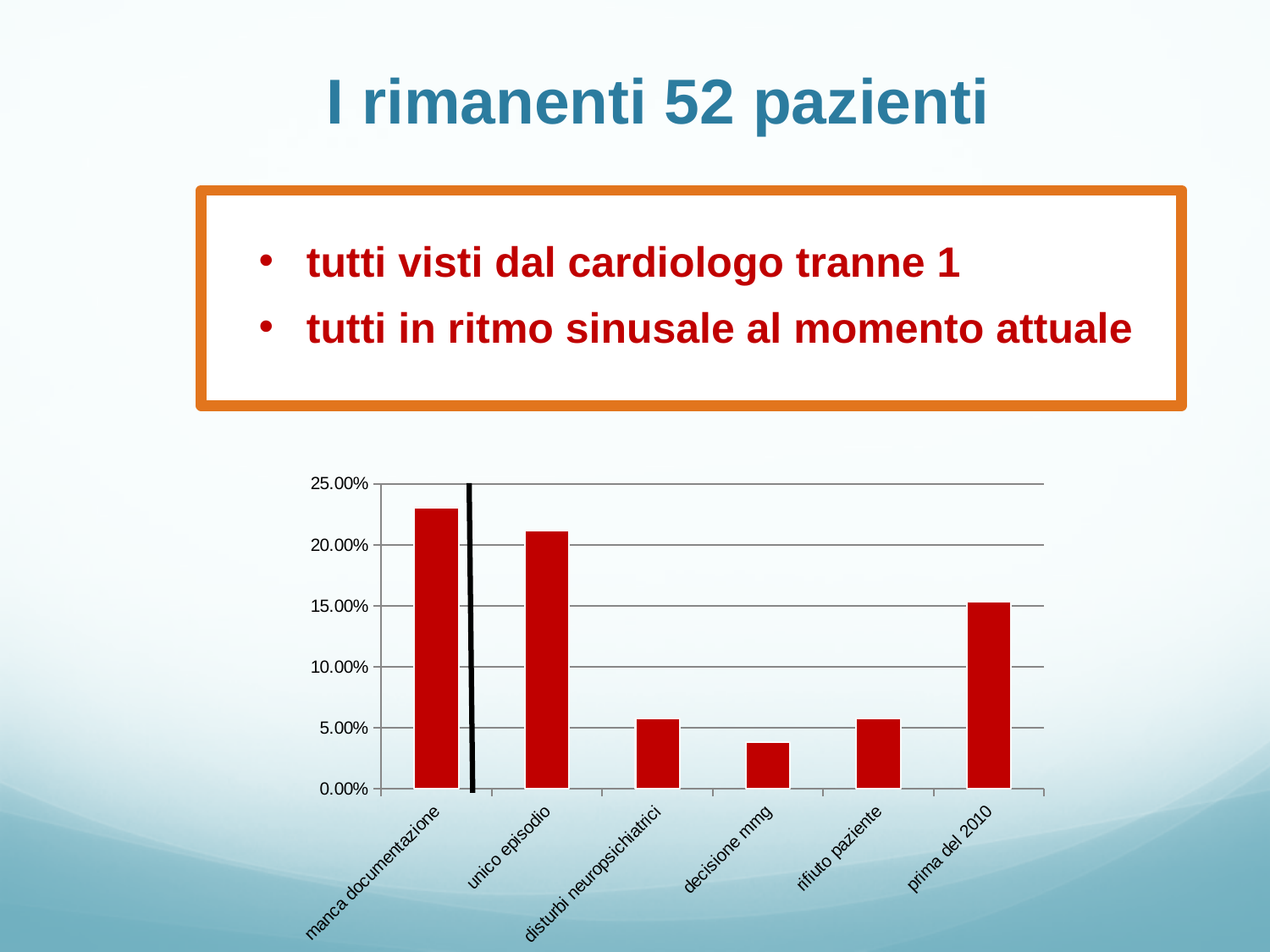
Is the value for manca documentazione greater or less than 20.00%? greater Which category has the lowest value in the chart? decisione mmg Which is larger, the value for disturbi neuropsichiatrici or the value for manca documentazione? manca documentazione Which category has the highest value in the chart? manca documentazione Is the value for prima del 2010 greater or less than 10.00%? greater What kind of chart is shown on the slide? bar chart How many categories are shown on the x axis of the chart? 6 Which is larger, the value for unico episodio or the value for prima del 2010? unico episodio Is the value for decisione mmg greater or less than 5.00%? less What colour are the bars in the chart? red